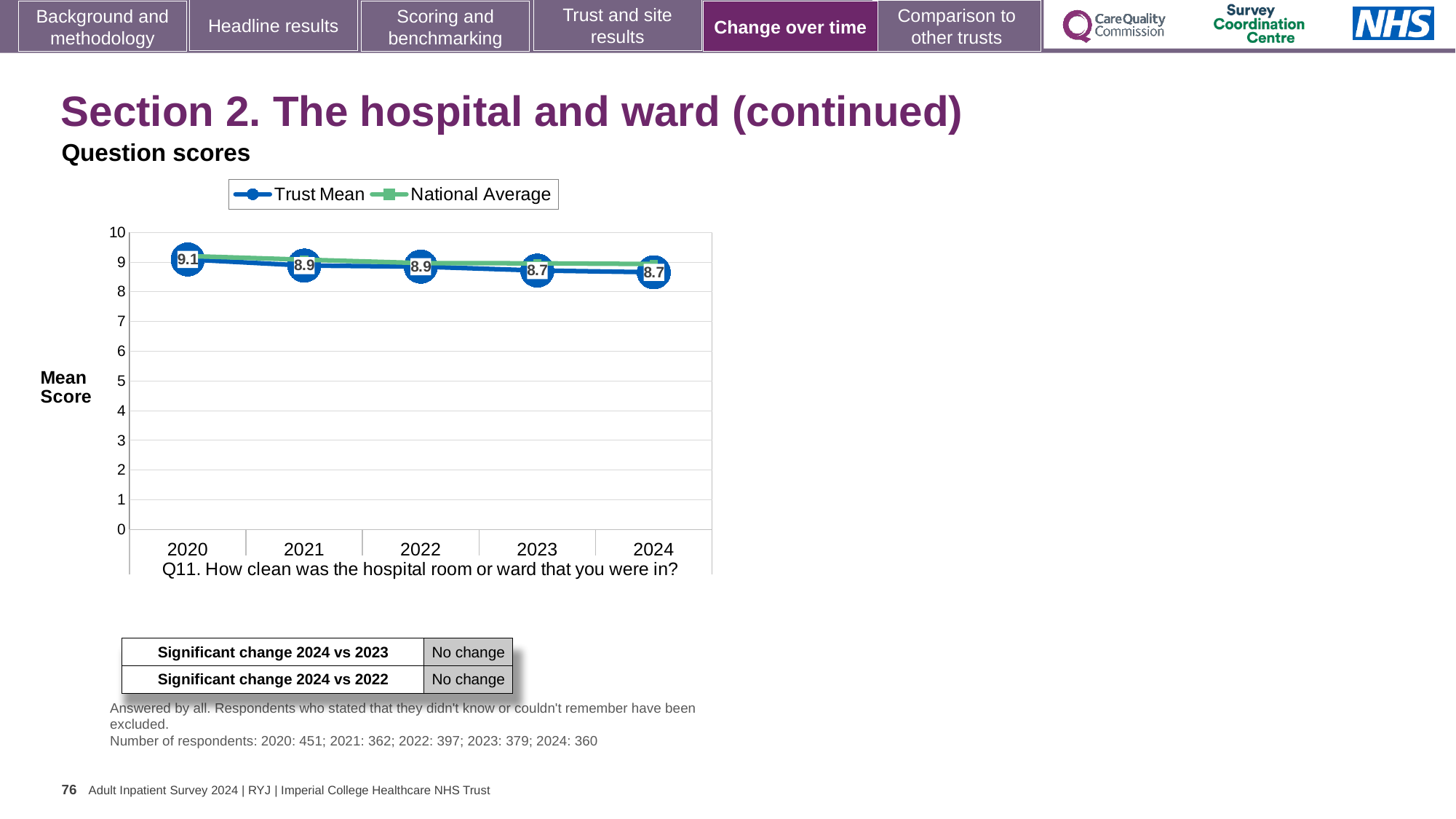
In which year is the Trust Mean highest? 2020 Is the National Average for 2024 greater or less than 8? greater Does the Trust Mean rise or fall from 2020 to 2024? Fall What is the Trust Mean for 2020? 9.1 Which question does the chart relate to? Q11. How clean was the hospital room or ward that you were in? How many series does the legend list? 2 What is the Trust Mean for 2024? 8.7 How many years are shown on the x axis? 5 What is the Trust Mean for 2022? 8.9 What is the difference between the Trust Mean in 2020 and in 2024? 0.4 What kind of chart is shown? Line chart Is the Trust Mean larger in 2021 or in 2023? 2021